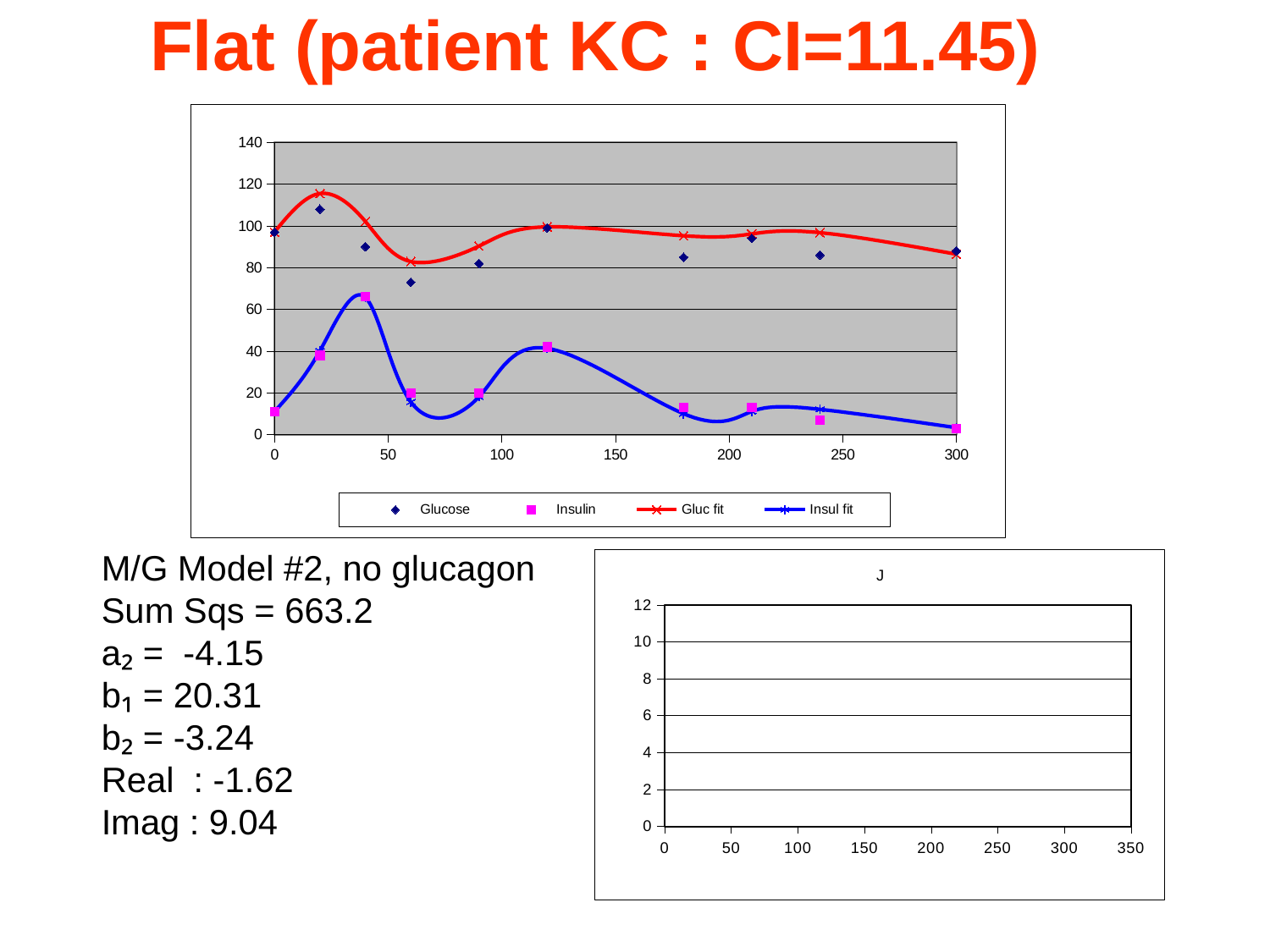
In the top chart, at which x value is the Insulin series highest? 40 In the top chart, is the Insulin value at x=40 greater or less than 60? greater In the top chart, at which x value is the Insulin series lowest? 300 In the top chart, how many Glucose data points are plotted? 10 What kind of chart is the top chart? Scatter chart with fitted lines What is the title of the bottom-right chart? J In the top chart, which is larger at x=0: the Glucose value or the Insulin value? Glucose In the top chart, is the Glucose value at x=20 greater or less than 100? greater In the top chart, is the Glucose value at x=60 greater or less than 80? less In the top chart, how many series does the legend list? 4 In the top chart, what are the names of the series in the legend? Glucose, Insulin, Gluc fit, Insul fit In the top chart, at which x value is the Glucose series highest? 20